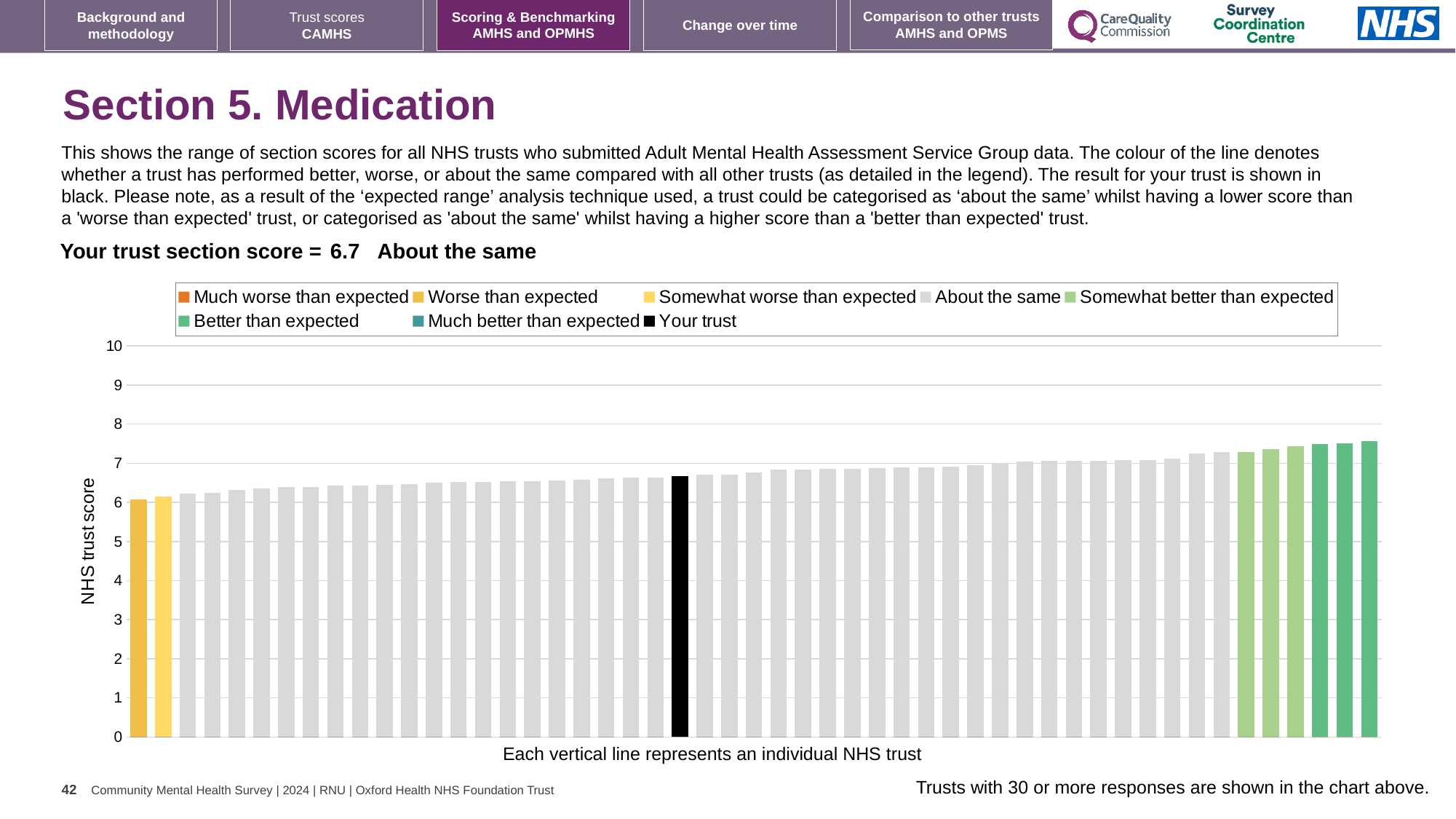
Is the value of the tallest bar greater or less than 7? greater Is the value of the leftmost bar greater or less than 7? less Do the bar values rise or fall from left to right along the x axis? rise What kind of chart is shown on the slide? bar chart Which is larger, the leftmost bar or the rightmost bar? the rightmost bar How many entries does the chart legend list? 8 What is the label on the vertical axis? NHS trust score What colour is the bar representing your trust? black Which category is your trust placed in for this section? About the same What is the section score for your trust? 6.7 Which legend category do the tallest bars on the right belong to? Better than expected Is the value for your trust greater or less than 6? greater